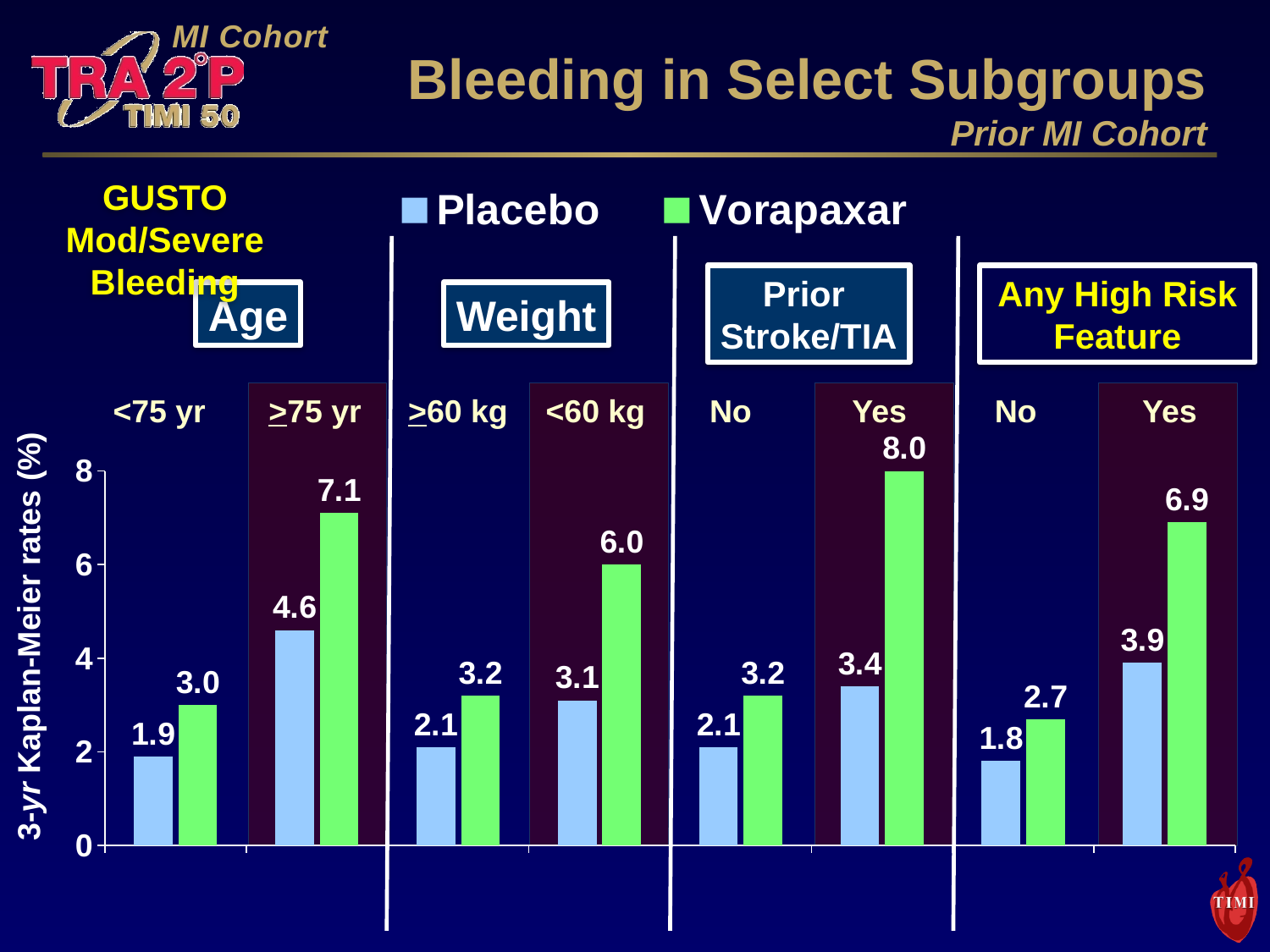
What is the difference between the Vorapaxar and Placebo values for the 'Yes' any high risk feature subgroup? 3.0 What is the Placebo value for the 'No' any high risk feature subgroup? 1.8 What is the Vorapaxar value for patients with prior stroke/TIA (Yes)? 8.0 What is the y-axis label of the chart? 3-yr Kaplan-Meier rates (%) What kind of chart is shown on the slide? Bar chart What is the Vorapaxar value for the ≥75 yr age subgroup? 7.1 Which subgroup has the highest Vorapaxar bleeding rate? Prior Stroke/TIA Yes What is the difference between the Vorapaxar and Placebo values for the ≥75 yr subgroup? 2.5 What is the Placebo value for the <60 kg weight subgroup? 3.1 Which is larger, the Vorapaxar value for <60 kg or the Vorapaxar value for ≥75 yr? ≥75 yr Which subgroup has the lowest Placebo bleeding rate? Any High Risk Feature No How many series does the legend list? 2